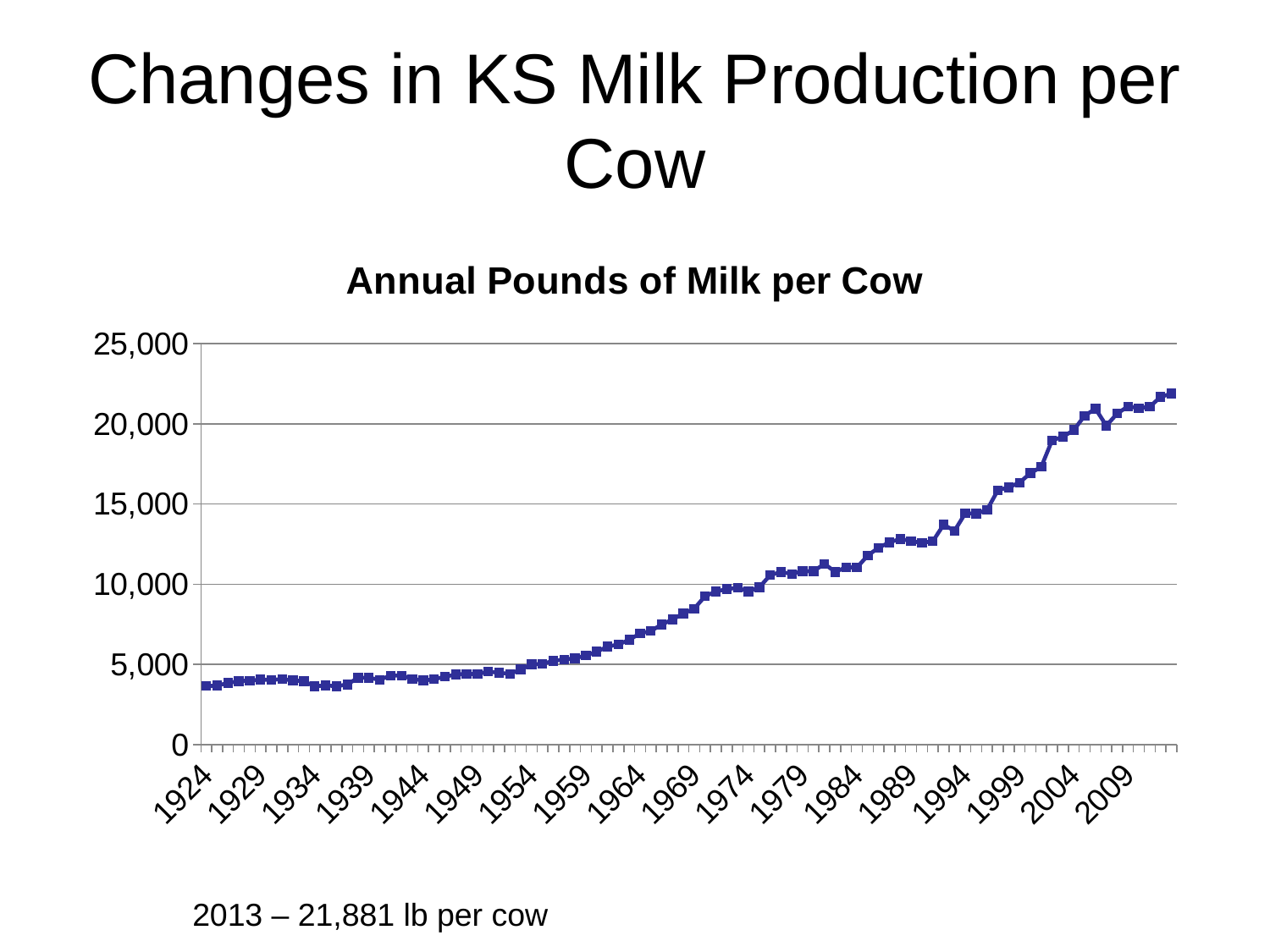
Is the value for 1924 greater or less than 5,000? less What is the highest value shown on the vertical axis? 25,000 Is the value for 1969 greater or less than 10,000? less According to the note below the chart, what was the milk production per cow in 2013? 21,881 lb per cow Do the values generally rise or fall from 1924 to the end of the series? rise Is the value for 1989 greater or less than 15,000? less What kind of chart is shown on the slide? line chart What is the title of the chart? Annual Pounds of Milk per Cow Which year has a higher value, 1924 or 2009? 2009